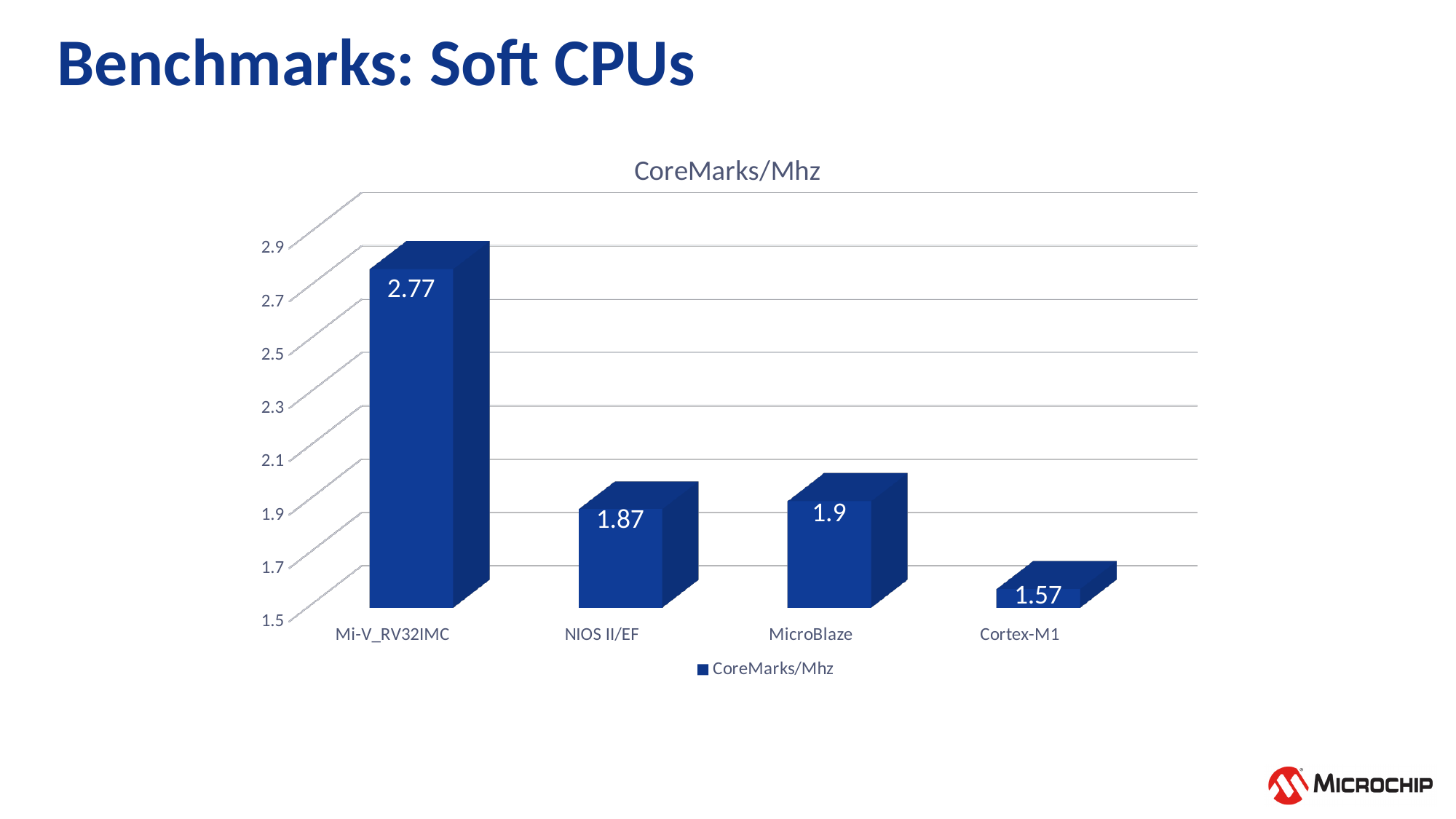
What is the CoreMarks/Mhz value for NIOS II/EF? 1.87 What is the title of the chart? CoreMarks/Mhz What is the difference in CoreMarks/Mhz between Mi-V_RV32IMC and Cortex-M1? 1.2 Which CPU has the lowest CoreMarks/Mhz value? Cortex-M1 What is the CoreMarks/Mhz value for Mi-V_RV32IMC? 2.77 What is the CoreMarks/Mhz value for Cortex-M1? 1.57 Which has a higher CoreMarks/Mhz value, Mi-V_RV32IMC or MicroBlaze? Mi-V_RV32IMC How many CPUs are shown on the chart? 4 What is the difference in CoreMarks/Mhz between MicroBlaze and NIOS II/EF? 0.03 Which CPU has the highest CoreMarks/Mhz value? Mi-V_RV32IMC What kind of chart is shown on the slide? Bar chart What is the CoreMarks/Mhz value for MicroBlaze? 1.9